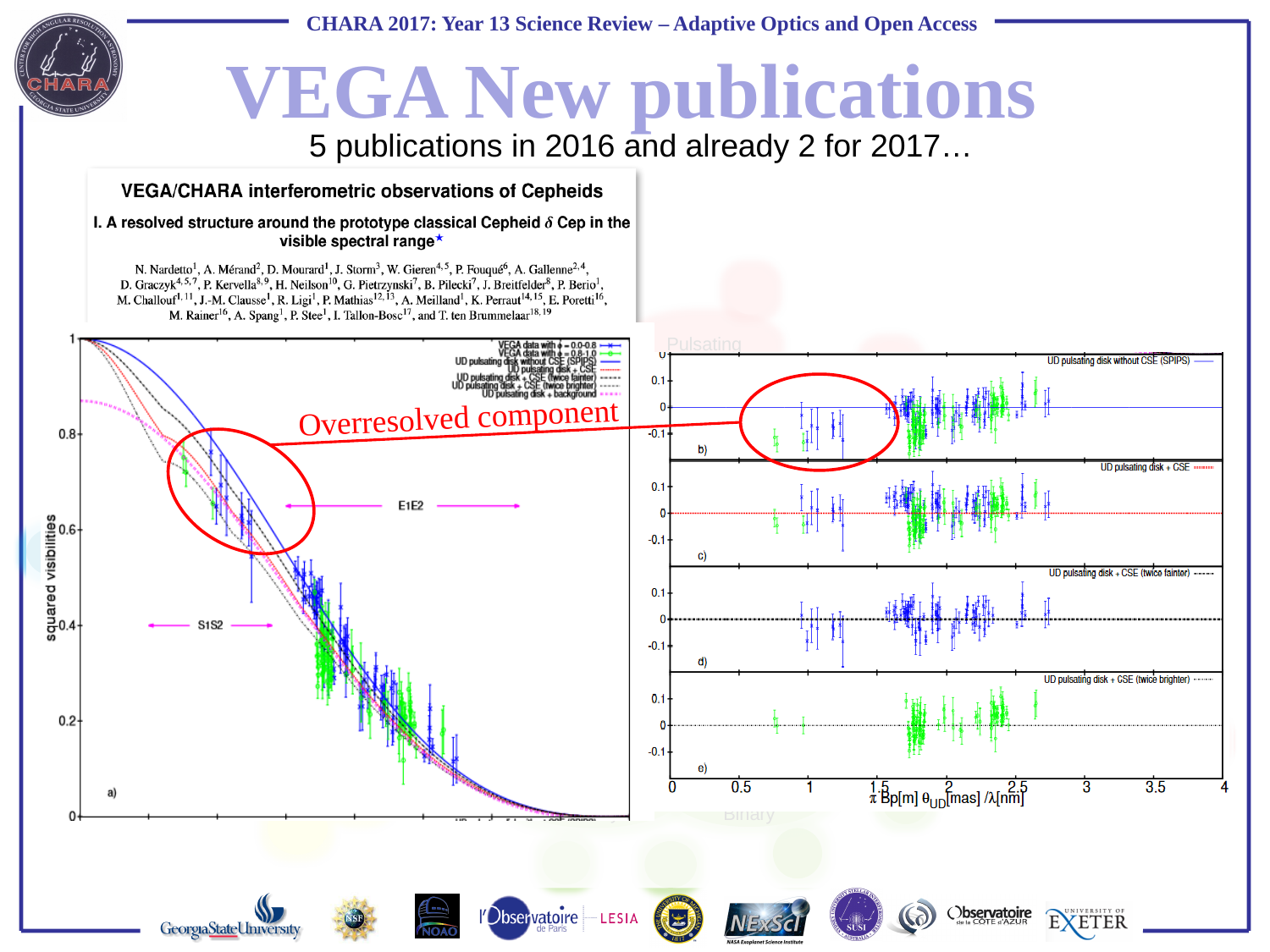
What is the lowest tick value shown on the y-axis of each right-hand residual panel? -0.1 Which model is named in the legend of residual panel b)? UD pulsating disk without CSE (SPIPS) How many residual panels (labelled b) to e)) are stacked on the right-hand side of the figure? 4 What kind of chart is the left-hand plot (panel a)? scatter plot with model curves (line chart) In the left-hand plot (panel a), do the squared visibilities rise or fall as the x-axis value increases? fall How many entries does the legend in the top-right corner of panel a) list? 7 What is the x-axis label of the right-hand residual panels? π Bp[m] θUD[mas] /λ[nm] What are the two baseline labels marked with horizontal arrows in panel a)? E1E2 and S1S2 Which model is named in the legend of residual panel e)? UD pulsating disk + CSE (twice brighter) What is the highest tick value shown on the y-axis of the left-hand plot (panel a)? 1 What is the largest tick value shown on the x-axis of the right-hand residual panels? 4 What is the label on the y-axis of the left-hand plot (panel a)? squared visibilities